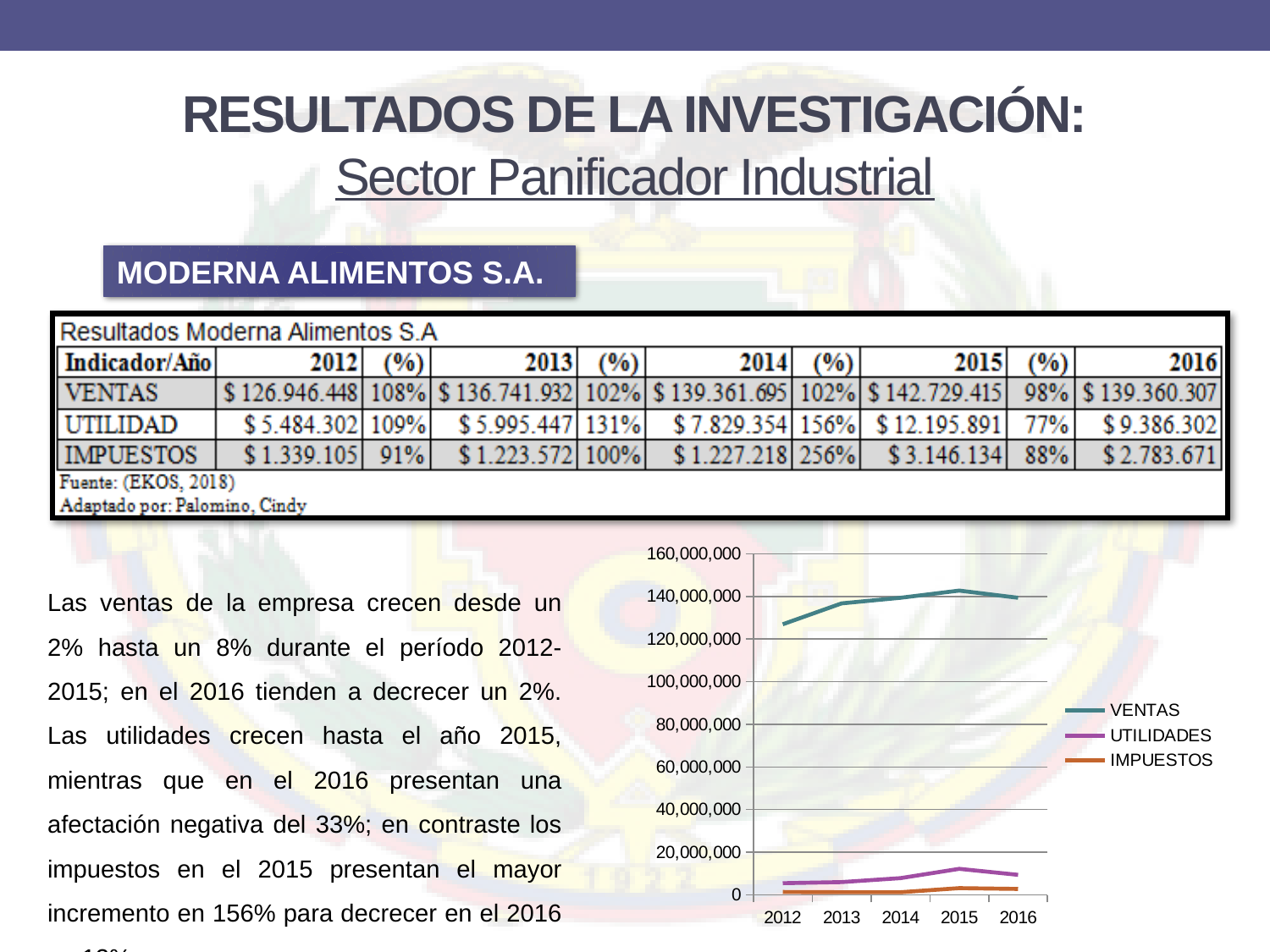
What kind of chart is shown on the slide? line chart Does the VENTAS line rise or fall from 2012 to 2015? rise In 2014, which series has the larger value, VENTAS or IMPUESTOS? VENTAS In which year is the VENTAS line at its lowest point? 2012 How many years are plotted along the x axis of the chart? 5 How many series does the chart legend list? 3 In which year does the VENTAS line reach its highest point? 2015 In which year does the UTILIDADES line reach its highest point? 2015 Is the VENTAS value for 2014 greater or less than 160,000,000? less What is the highest value shown on the chart's y axis? 160,000,000 Is the VENTAS value for 2012 greater or less than 120,000,000? greater Is the UTILIDADES value for 2015 greater or less than 20,000,000? less